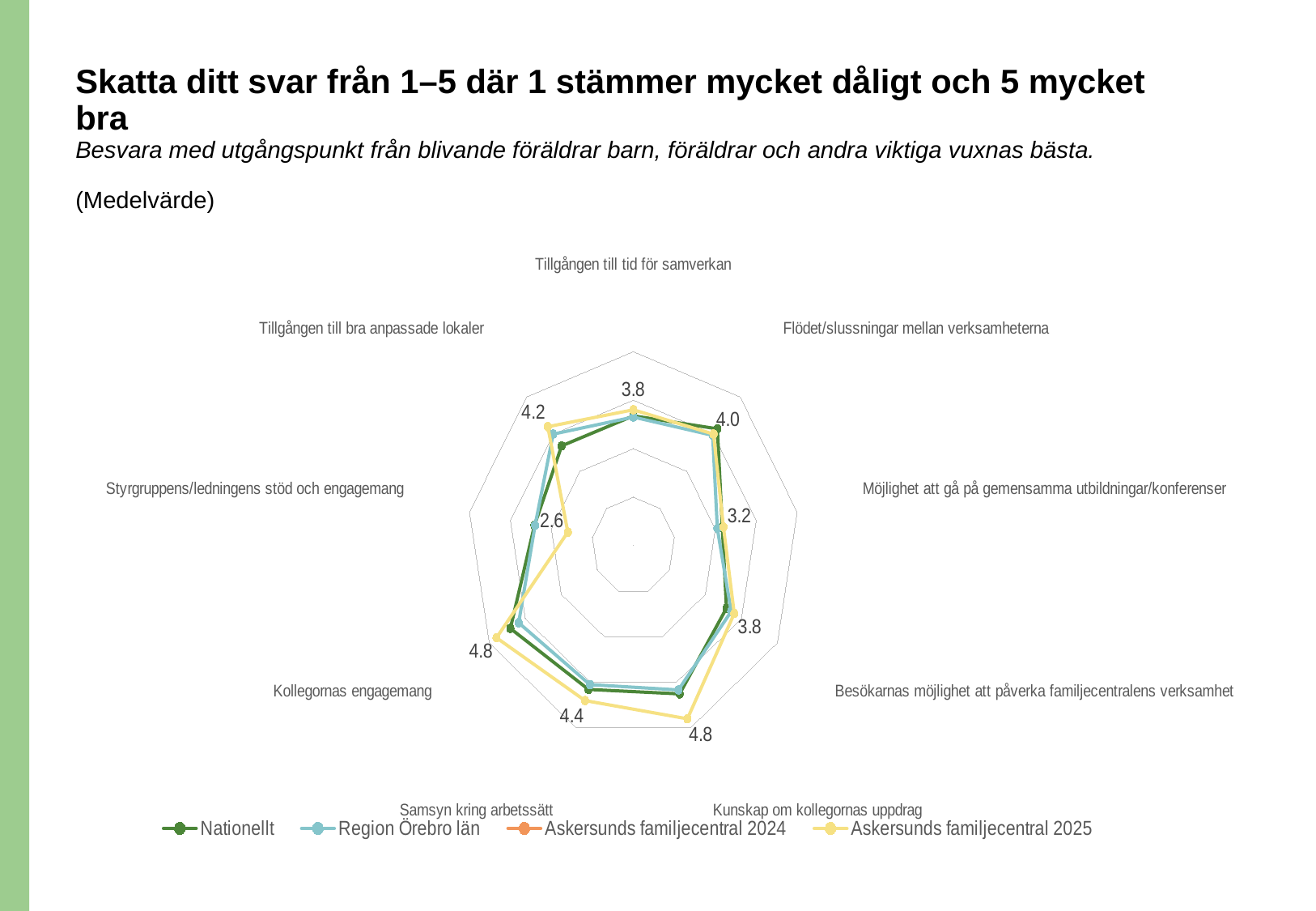
What is the value for Askersunds familjecentral 2025 on 'Tillgången till bra anpassade lokaler'? 4.2 For Askersunds familjecentral 2025, which is larger: 'Flödet/slussningar mellan verksamheterna' or 'Möjlighet att gå på gemensamma utbildningar/konferenser'? Flödet/slussningar mellan verksamheterna What is the value for Askersunds familjecentral 2025 on 'Samsyn kring arbetssätt'? 4.4 What is the value for Askersunds familjecentral 2025 on 'Möjlighet att gå på gemensamma utbildningar/konferenser'? 3.2 Which category has the lowest value for Askersunds familjecentral 2025? Styrgruppens/ledningens stöd och engagemang Which legend entry is shown in yellow? Askersunds familjecentral 2025 What is the value for Askersunds familjecentral 2025 on 'Tillgången till tid för samverkan'? 3.8 What is the difference between the Askersunds familjecentral 2025 values for 'Kollegornas engagemang' (4.8) and 'Styrgruppens/ledningens stöd och engagemang' (2.6)? 2.2 How many series does the legend list? 4 What kind of chart is shown on the slide? Radar chart What is the value for Askersunds familjecentral 2025 on 'Styrgruppens/ledningens stöd och engagemang'? 2.6 How many categories (axes) does the radar chart have? 9